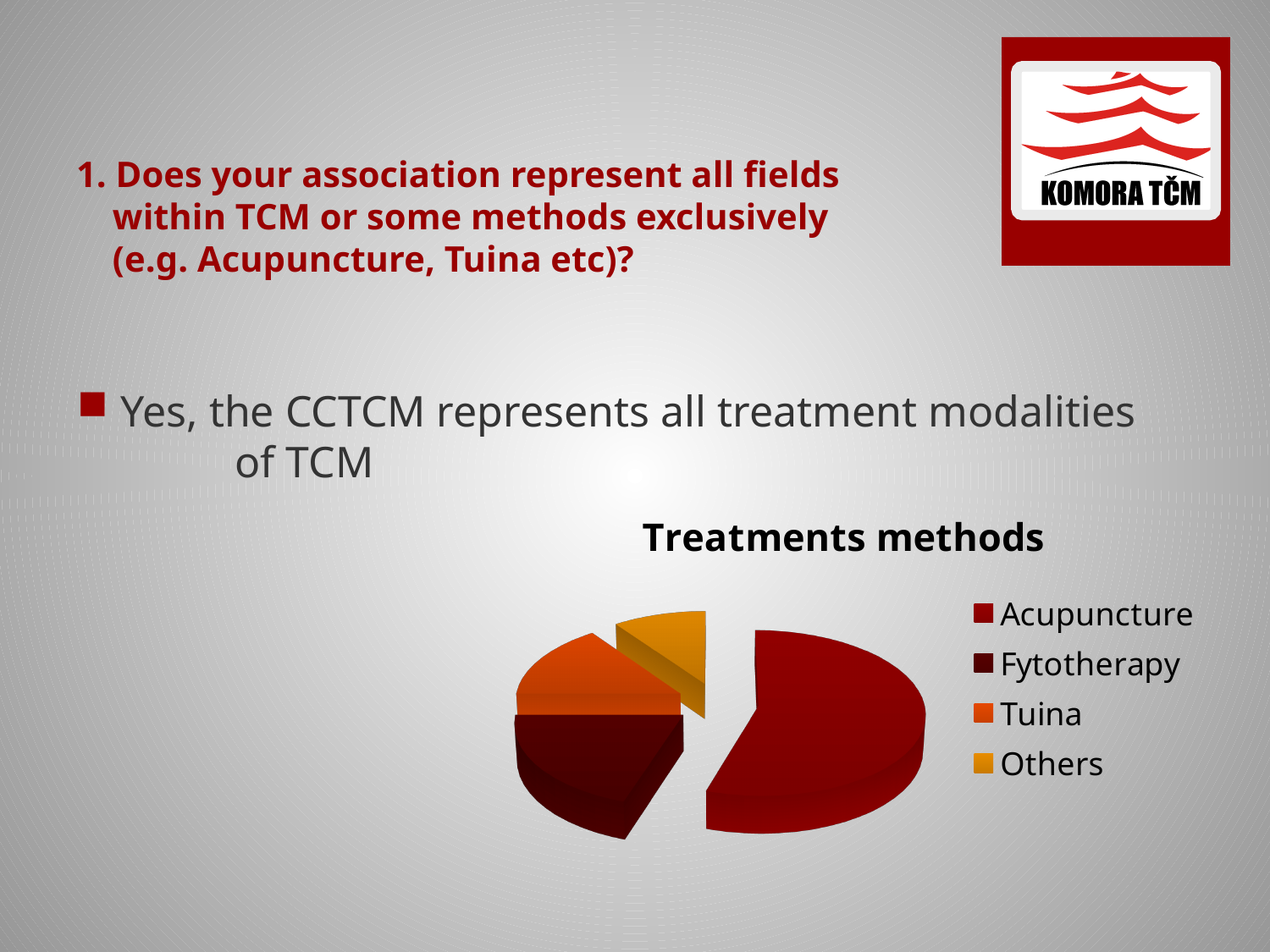
How many slices does the pie chart have? 4 How many entries does the chart legend list? 4 Which slice is larger, Fytotherapy or Others? Fytotherapy Which slice is larger, Tuina or Others? Tuina Which treatment method has the smallest slice of the pie? Others Which legend entry is shown in orange? Tuina What is the title of the chart? Treatments methods What kind of chart is shown on the slide? Pie chart Which treatment method has the largest slice of the pie? Acupuncture Which slice is larger, Acupuncture or Fytotherapy? Acupuncture